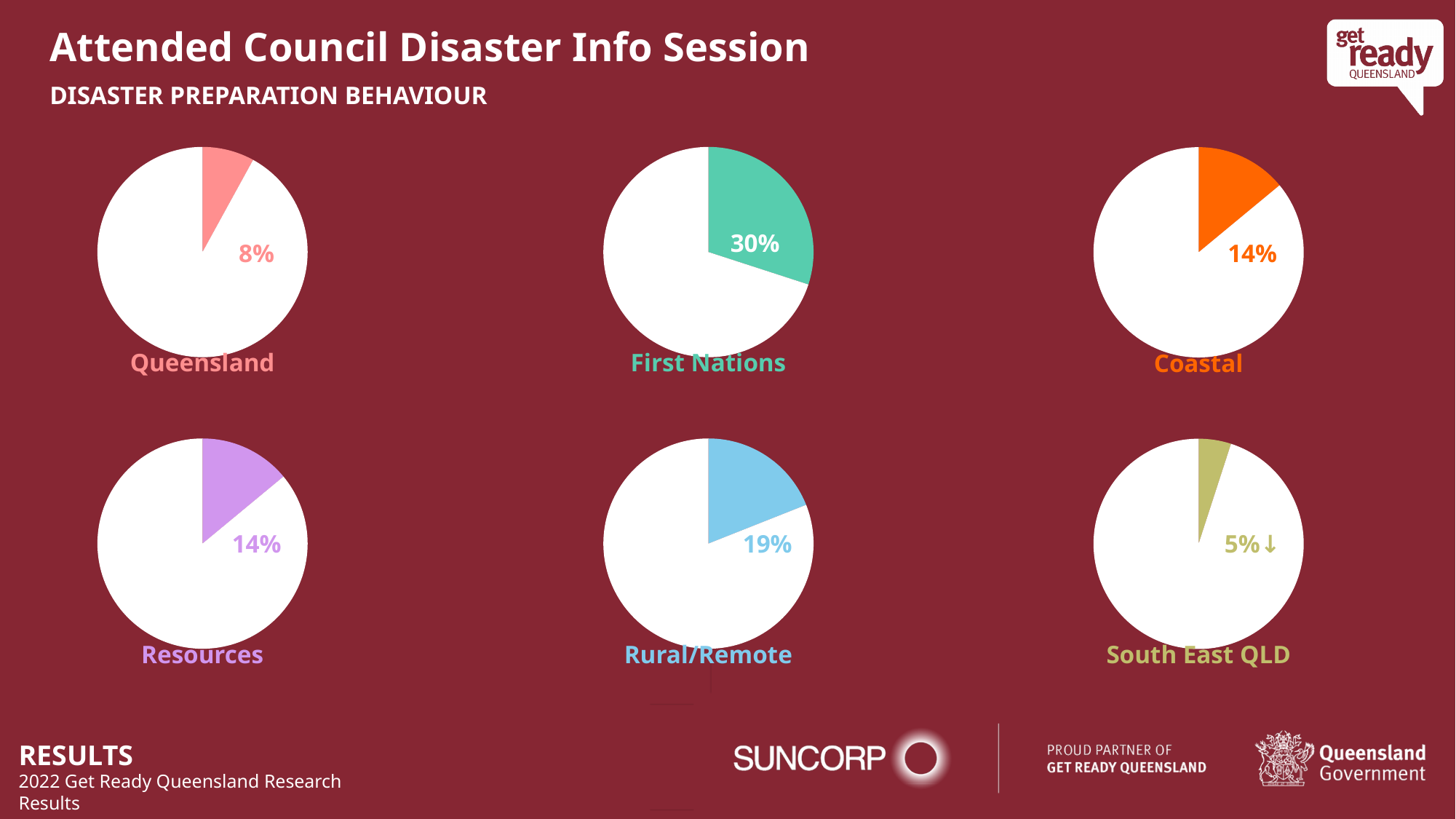
Which is larger, the Rural/Remote percentage or the Resources percentage? Rural/Remote In the South East QLD pie chart, what percentage is shown? 5% In the First Nations pie chart, what percentage is shown for the highlighted slice? 30% What kind of chart is used to show each group's percentage on this slide? Pie chart Across the six pie charts, which group has the lowest percentage? South East QLD In the Queensland pie chart, what percentage attended a council disaster info session? 8% What is the difference between the First Nations percentage and the Queensland percentage? 22% How many pie charts are on the slide? 6 In the Coastal pie chart, what percentage is shown? 14% In the Rural/Remote pie chart, what percentage is shown? 19% Across the six pie charts, which group has the highest percentage? First Nations Which two groups share the same percentage of 14%? Coastal and Resources